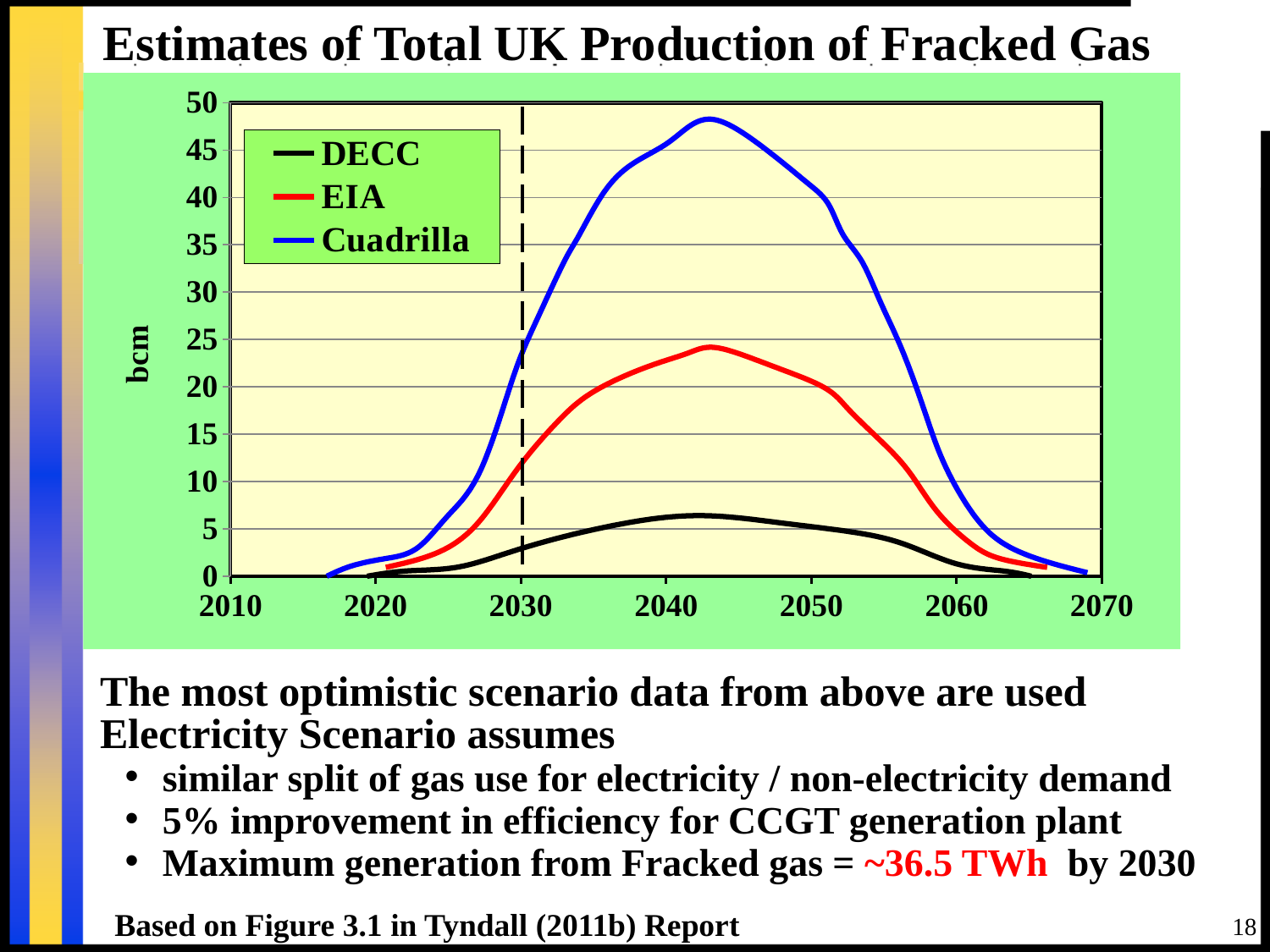
What is the label on the y axis of the chart? bcm Is the peak value of the Cuadrilla series greater or less than 45? greater Is the Cuadrilla value in 2030 greater or less than 20? greater Which series is higher in 2050, EIA or DECC? EIA What is the title of the chart? Estimates of Total UK Production of Fracked Gas Which series has the lowest peak value? DECC Is the peak value of the DECC series greater or less than 10? less How many series does the legend list? 3 What kind of chart is shown on the slide? line chart Does the Cuadrilla series rise or fall between 2050 and 2060? fall Which series reaches the highest peak value? Cuadrilla